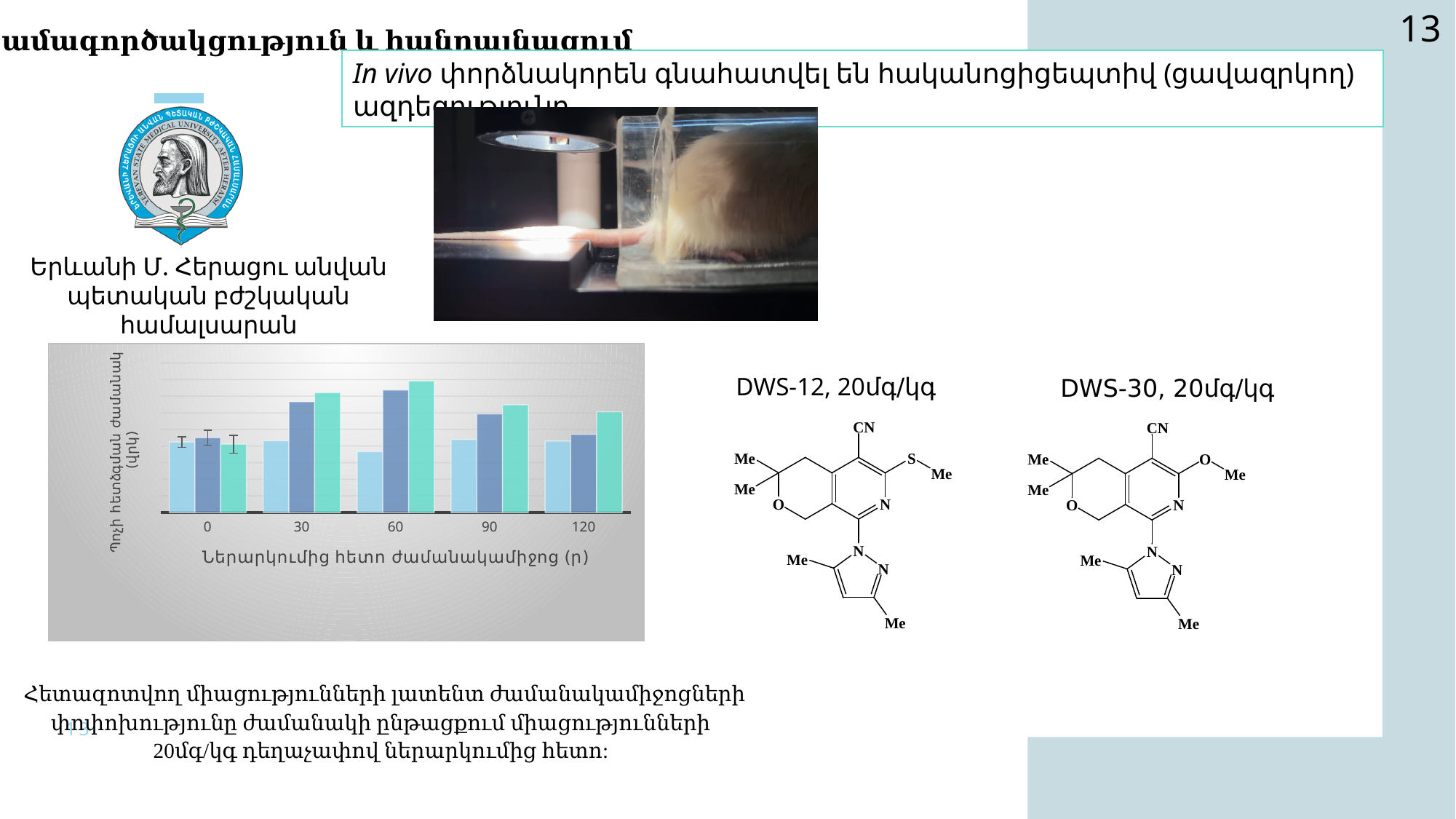
How many categories are shown along the x axis of the bar chart? 5 At which x-axis category of the bar chart are error bars drawn on the bars? 0 In the bar chart, at which x-axis category is the dark blue (middle) bar the tallest? 60 In the bar chart, at which x-axis category is the teal (right) bar the tallest? 60 In the bar chart, at category 30, which is taller: the dark blue bar or the light blue bar? dark blue bar How many bars are plotted for each x-axis category in the bar chart? 3 What is the x-axis title of the bar chart? Ներարկումից հետո ժամանակամիջոց (ր) In the bar chart, at category 60, which is taller: the teal bar or the light blue bar? teal bar What are the category labels on the x axis of the bar chart? 0, 30, 60, 90, 120 What kind of chart is shown on the left of the slide? bar chart In the bar chart, at which x-axis category is the light blue (left) bar the shortest? 60 In the bar chart, do the dark blue bars rise or fall from category 60 to category 120? fall